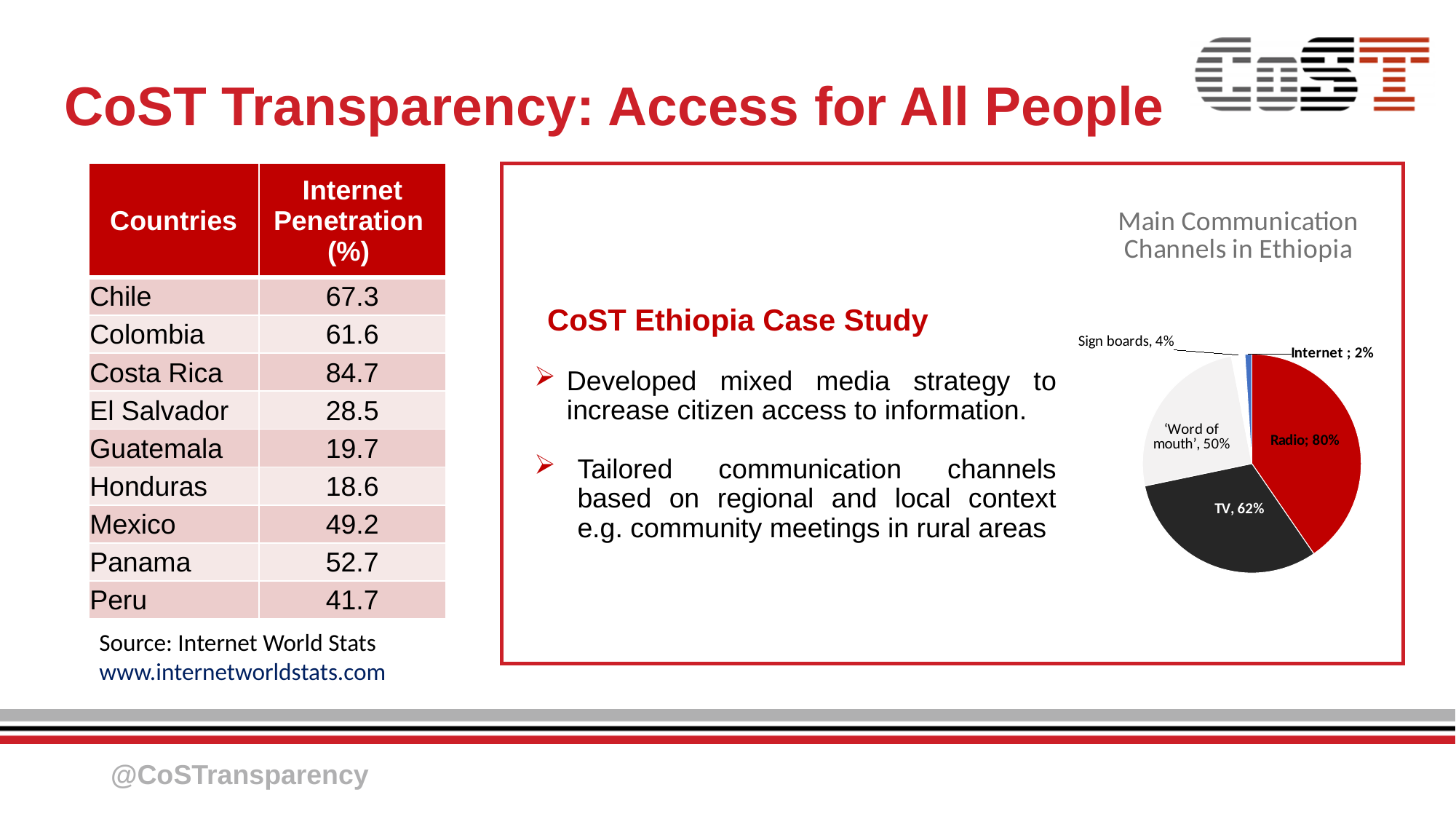
What kind of chart is shown on the slide? Pie chart What percentage is shown for TV in the pie chart? 62% Which communication channel has the largest slice in the pie chart? Radio What is the title of the pie chart? Main Communication Channels in Ethiopia How many percentage points higher is Radio than TV in the pie chart? 18 What percentage is shown for Radio in the pie chart? 80% Which communication channel has the smallest slice in the pie chart? Internet What percentage is shown for Internet in the pie chart? 2% What percentage is shown for Sign boards in the pie chart? 4% How many communication channels are shown in the pie chart? 5 Which is larger in the pie chart, TV or 'Word of mouth'? TV What percentage is shown for 'Word of mouth' in the pie chart? 50%